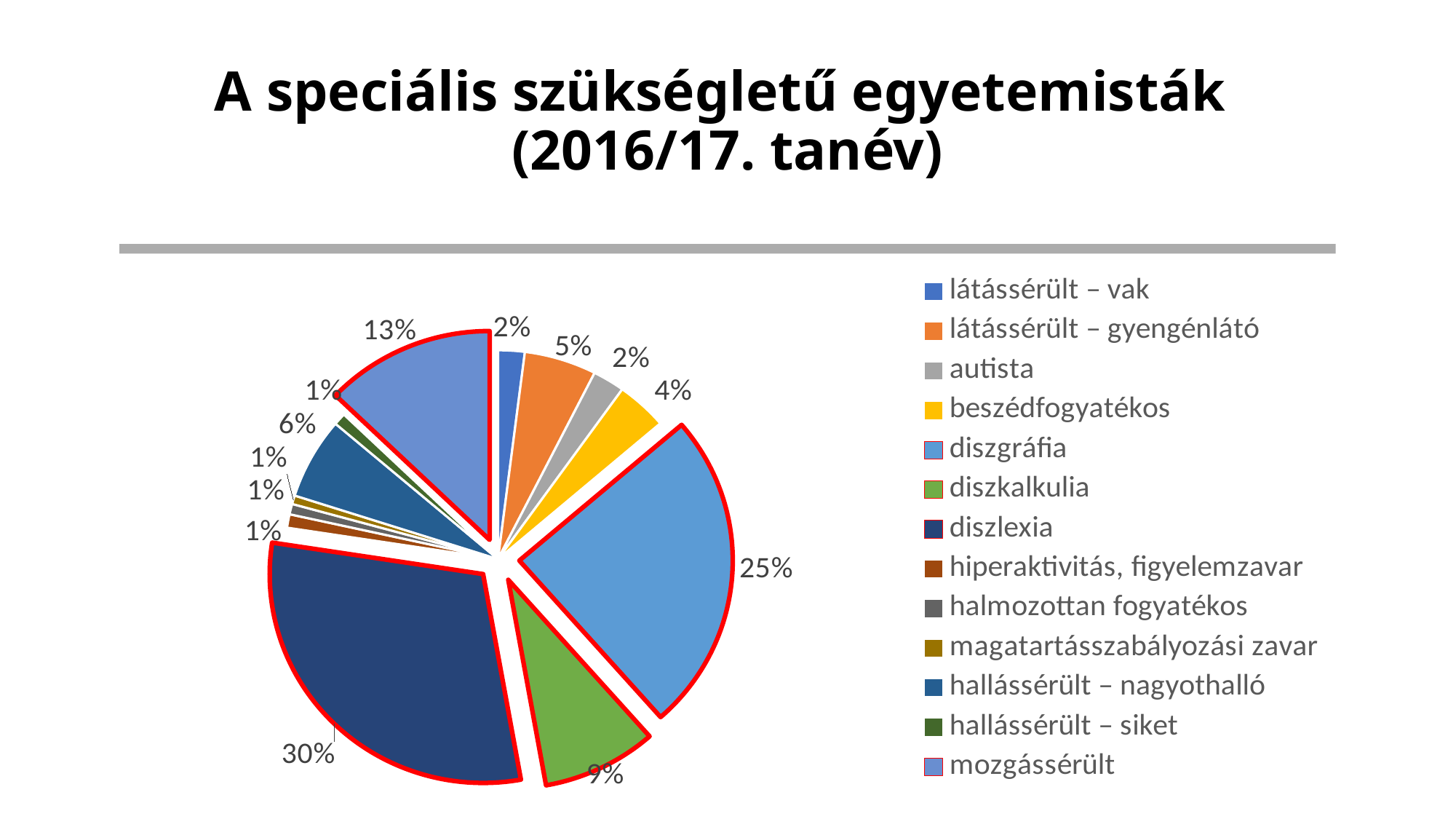
What share of the pie does diszkalkulia have? 9% Which category has the largest slice of the pie? diszlexia What share of the pie does látássérült – gyengénlátó have? 5% What share of the pie does diszgráfia have? 25% How many categories does the legend list? 13 What share of the pie does mozgássérült have? 13% What kind of chart is shown on the slide? pie chart What is the title of the slide? A speciális szükségletű egyetemisták (2016/17. tanév) What share of the pie does diszlexia have? 30% What share of the pie does hallássérült – nagyothalló have? 6% Which is larger, the share of mozgássérült or the share of diszkalkulia? mozgássérült What is the difference between the shares of diszlexia and diszgráfia? 5%